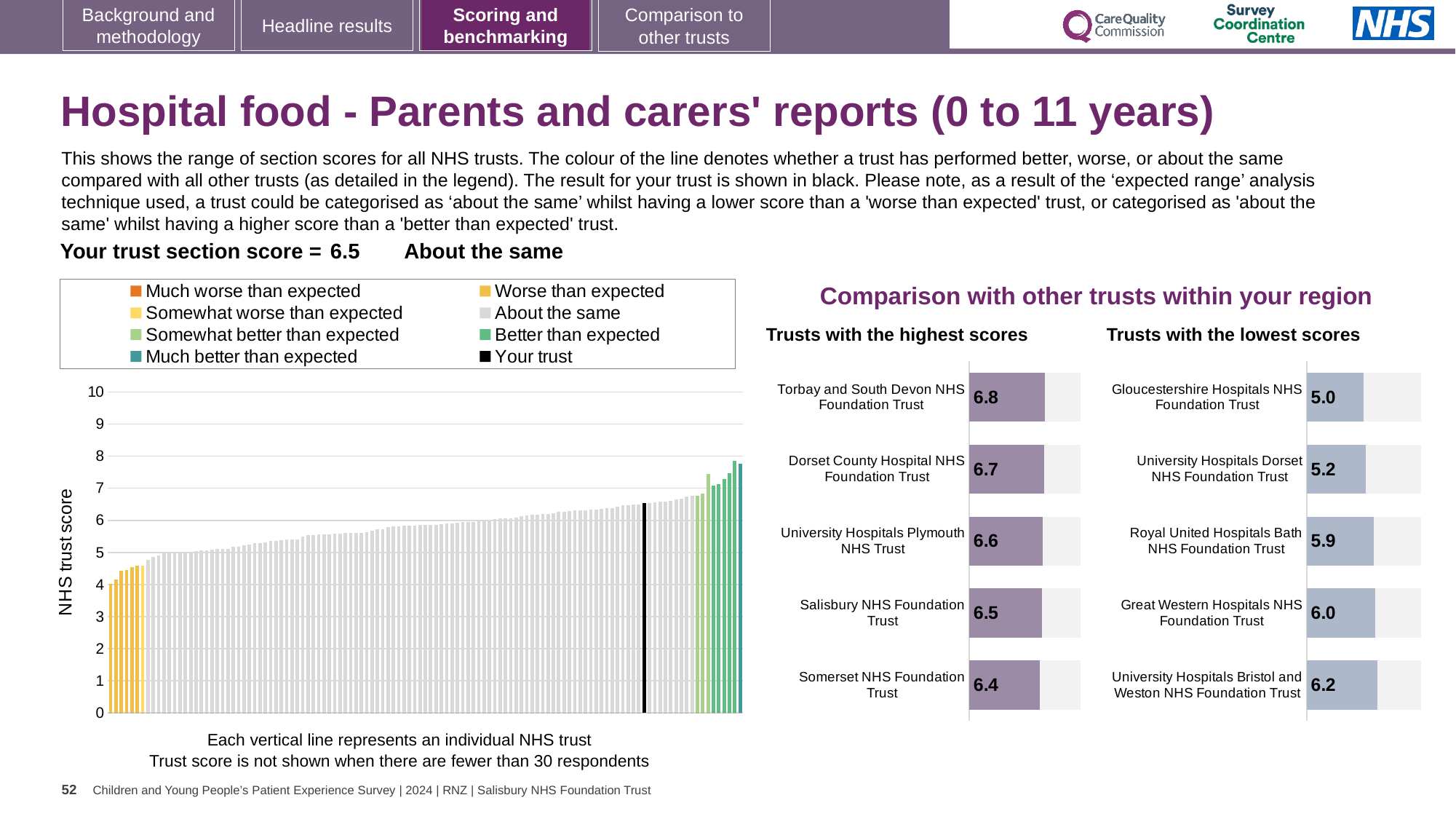
In the NHS trust score chart on the left, what colour is the bar representing your trust? Black In the 'Trusts with the highest scores' chart, which trust has the highest score? Torbay and South Devon NHS Foundation Trust In the 'Trusts with the lowest scores' chart, what is the score for Gloucestershire Hospitals NHS Foundation Trust? 5.0 What kind of chart is the NHS trust score chart on the left? Bar chart In the NHS trust score chart on the left, is the value of the leftmost bar greater or less than 5? less In the 'Trusts with the highest scores' chart, what is the difference between the scores of Torbay and South Devon NHS Foundation Trust and Somerset NHS Foundation Trust? 0.4 How many entries does the legend of the NHS trust score chart list? 8 In the 'Trusts with the lowest scores' chart, which trust has the lowest score? Gloucestershire Hospitals NHS Foundation Trust How many trusts are shown in the 'Trusts with the lowest scores' chart? 5 In the NHS trust score chart on the left, do the bars rise or fall from left to right? Rise In the 'Trusts with the lowest scores' chart, which has the larger score: University Hospitals Dorset NHS Foundation Trust or Royal United Hospitals Bath NHS Foundation Trust? Royal United Hospitals Bath NHS Foundation Trust In the 'Trusts with the highest scores' chart, what is the score for Torbay and South Devon NHS Foundation Trust? 6.8